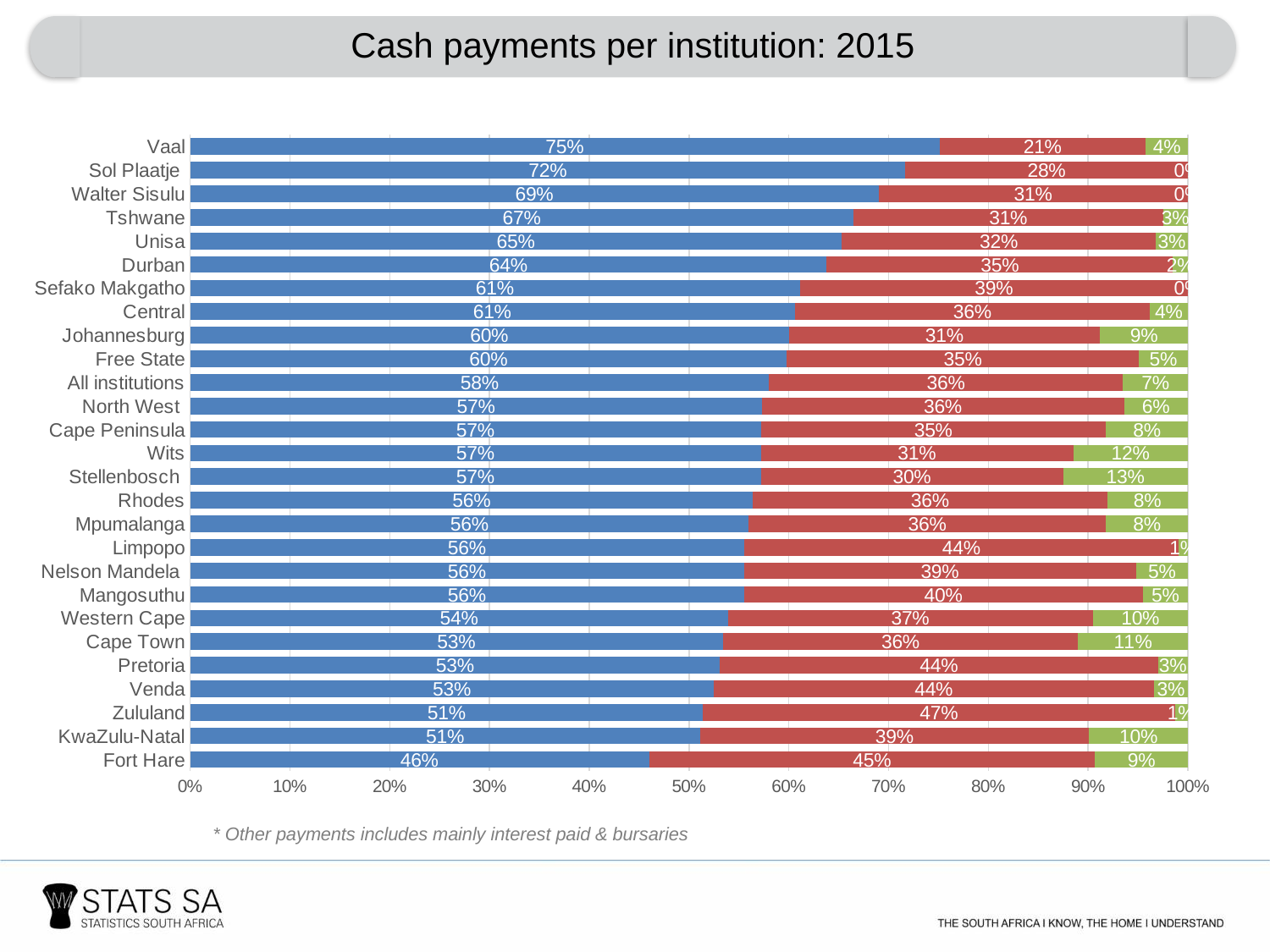
What is the difference between the blue segment values for Vaal and Fort Hare? 29% What is the value of the red segment for Zululand? 47% How many institutions (categories) are listed on the chart? 27 What is the value of the blue segment for All institutions? 58% What is the value of the blue segment for Vaal? 75% Which institution has the lowest blue segment value? Fort Hare What is the value of the green segment for Stellenbosch? 13% Which institution has the highest blue segment value? Vaal What is the title of the chart? Cash payments per institution: 2015 What is the value of the green segment for Wits? 12% What type of chart is shown on the slide? Stacked bar chart Which is larger, the red segment for Limpopo or the red segment for Johannesburg? Limpopo